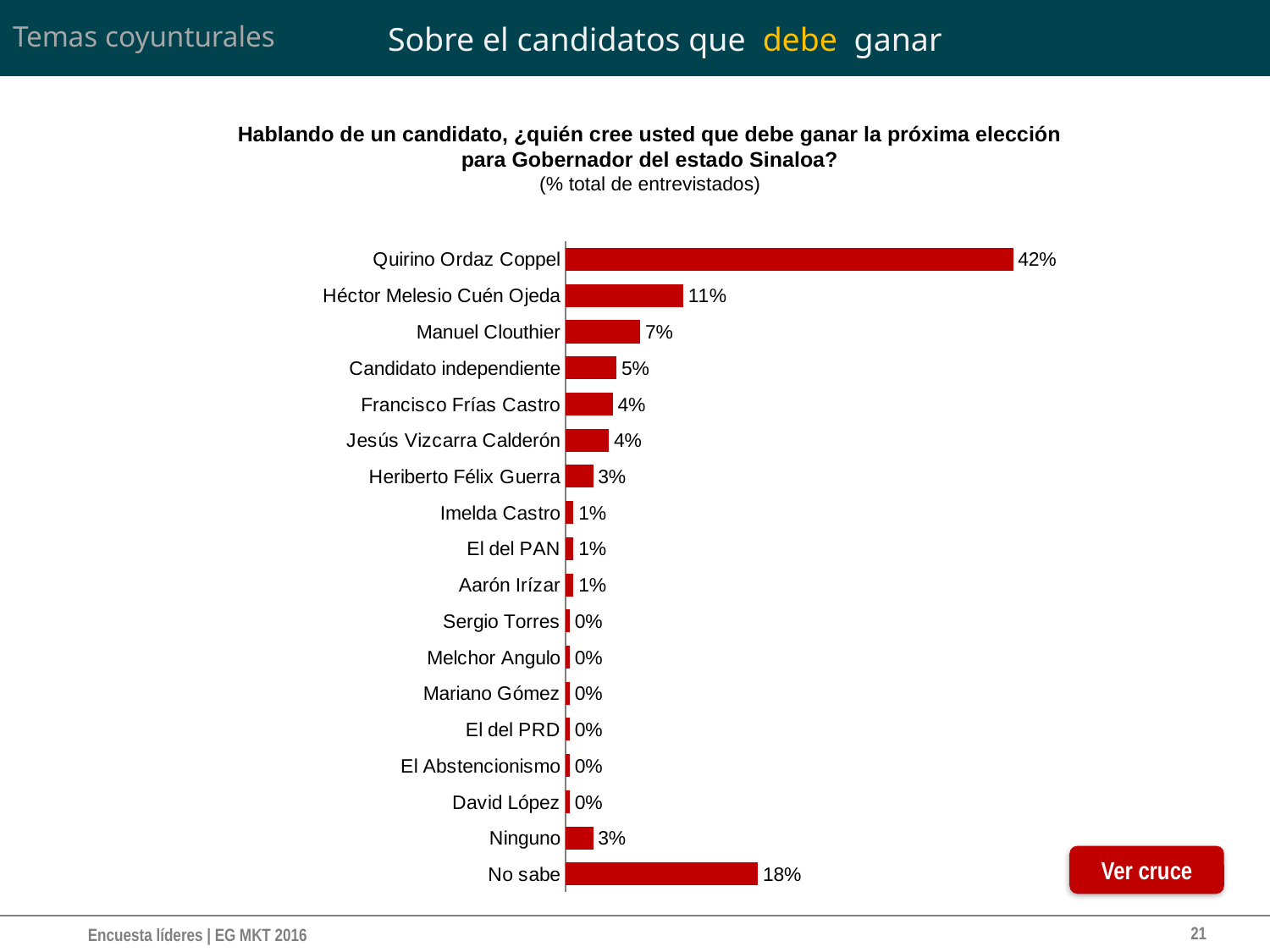
What is the difference between the values for Quirino Ordaz Coppel and Héctor Melesio Cuén Ojeda? 31 percentage points What percentage of respondents said Quirino Ordaz Coppel should win? 42% Which category has the highest value in the chart? Quirino Ordaz Coppel What is the value for Manuel Clouthier? 7% What is the value shown for 'Ninguno'? 3% What is the value shown for Héctor Melesio Cuén Ojeda? 11% What percentage is shown for 'No sabe'? 18% Which is larger, the value for 'No sabe' or the value for Héctor Melesio Cuén Ojeda? No sabe What type of chart is shown on the slide? Bar chart How many categories are shown in the chart? 18 What colour are the bars in the chart? Red What is the difference between the values for Manuel Clouthier and Candidato independiente? 2 percentage points